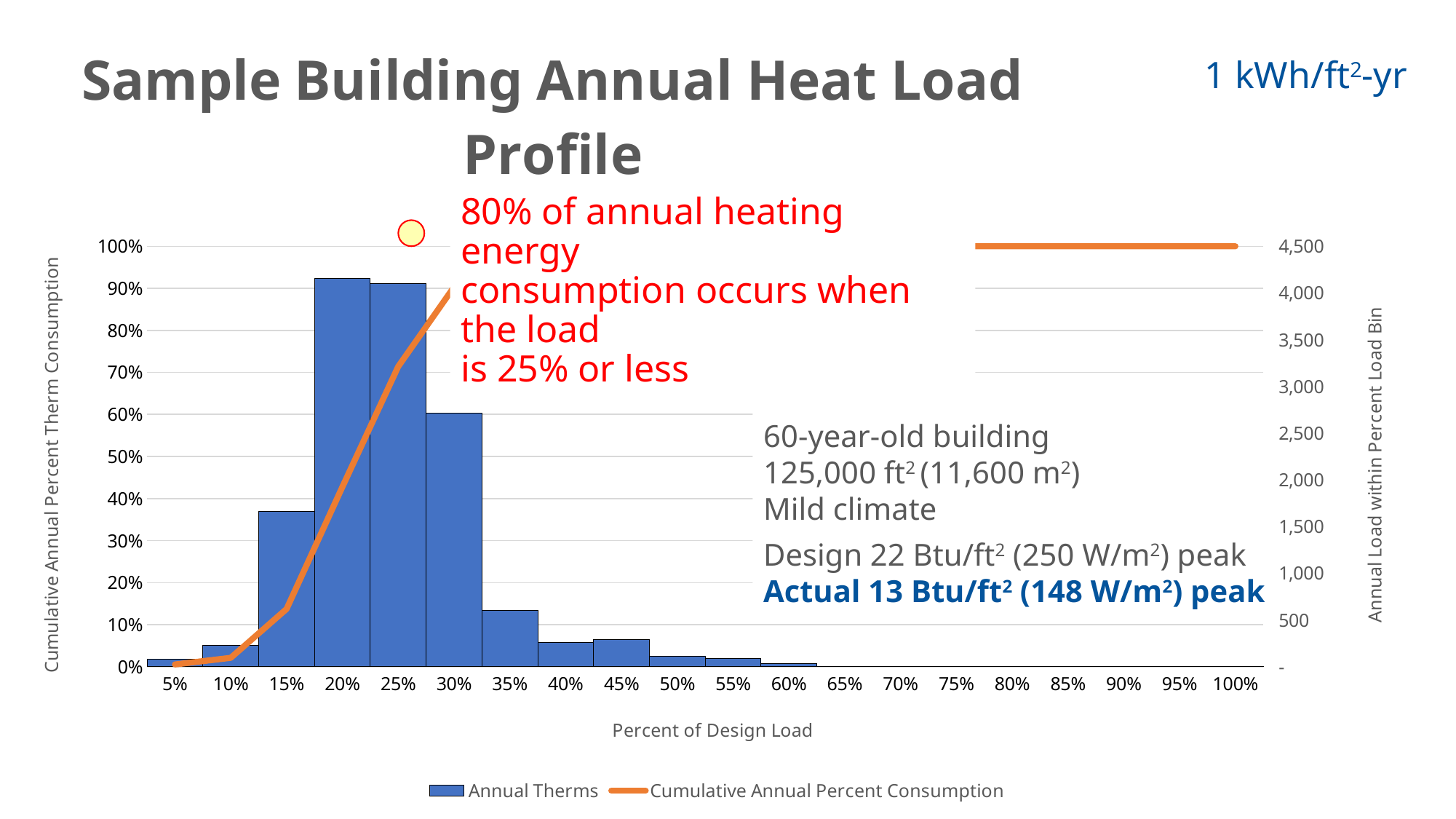
Which bin has the larger Annual Therms bar, 15% or 30%? 30% Is the Annual Therms bar for the 30% bin greater or less than 2,500? greater How many series does the chart legend list? 2 What is the title of the x axis? Percent of Design Load What are the two series named in the legend? Annual Therms and Cumulative Annual Percent Consumption Does the Cumulative Annual Percent Consumption line rise or fall as the percent of design load increases? Rises Is the Annual Therms bar for the 40% bin greater or less than 500? less How many percent-of-design-load bins are shown along the x axis? 20 What kind of chart is shown on the slide? A combination bar and line chart Is the Cumulative Annual Percent Consumption at the 30% bin greater or less than 80%? greater What is the Cumulative Annual Percent Consumption value at the 100% design load bin? 100%